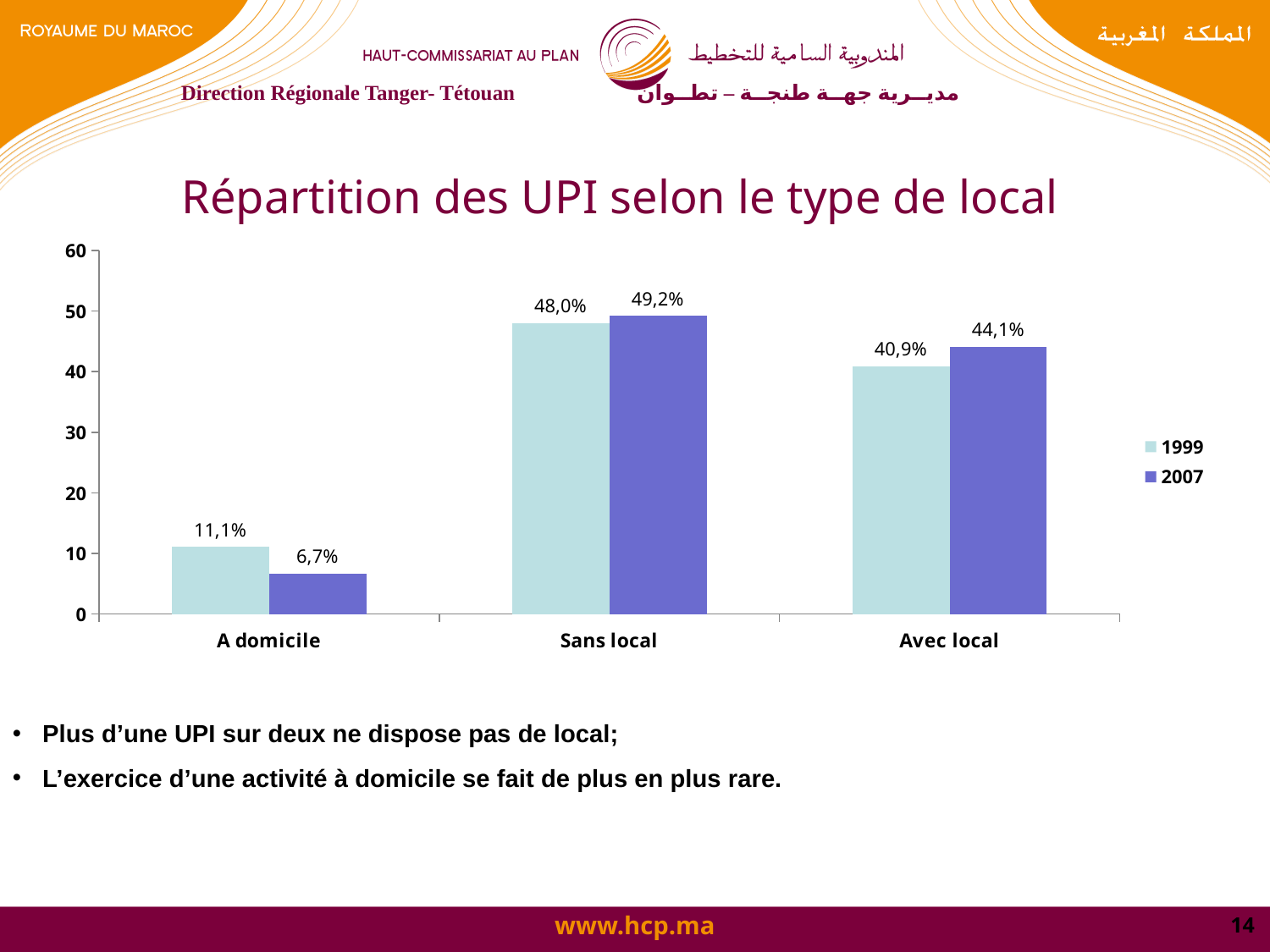
What is the value for 'Sans local' in 2007? 49,2% What is the value for 'A domicile' in 1999? 11,1% Which category has the highest value in 2007? Sans local What is the difference between the 1999 and 2007 values for 'A domicile'? 4,4% Which category has the lowest value in 1999? A domicile How many categories are shown on the x axis? 3 What kind of chart is shown on the slide? Bar chart Is the value for 'Sans local' in 1999 greater or less than 40? greater What is the title of the chart? Répartition des UPI selon le type de local How many series does the legend list? 2 What is the value for 'Avec local' in 1999? 40,9% Which is larger for 'Avec local': the 1999 value or the 2007 value? 2007